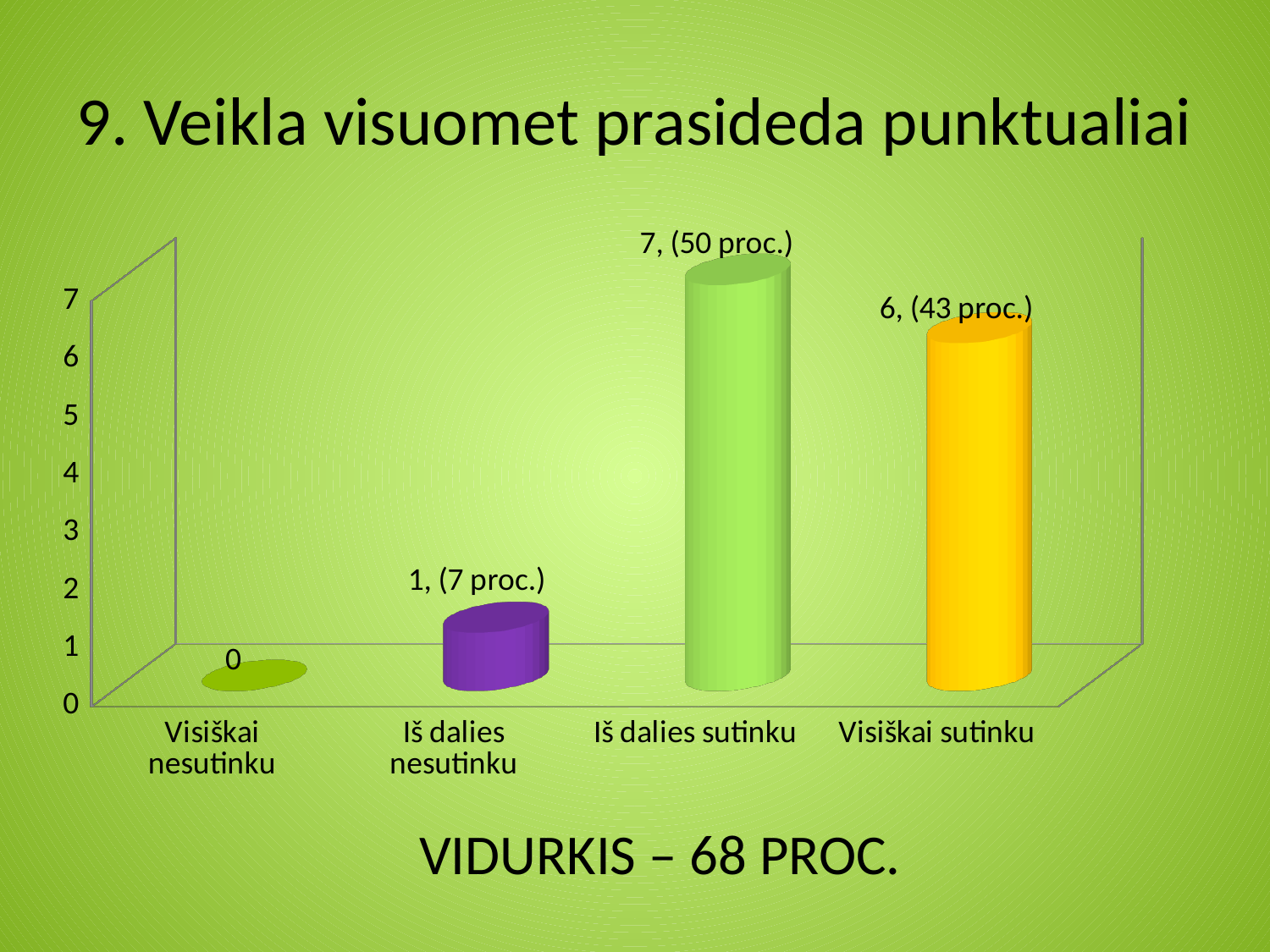
What value is shown for "Visiškai nesutinku"? 0 What is the title of the slide containing the chart? 9. Veikla visuomet prasideda punktualiai What is the difference in count between "Iš dalies sutinku" and "Visiškai sutinku"? 1 Which category has the lowest value? Visiškai nesutinku Which category has the highest value? Iš dalies sutinku Which is larger, the value for "Iš dalies nesutinku" or the value for "Visiškai sutinku"? Visiškai sutinku Is the value for "Visiškai sutinku" greater or less than 4? greater What value is shown for "Visiškai sutinku"? 6, (43 proc.) What value is shown for "Iš dalies sutinku"? 7, (50 proc.) How many categories are shown on the x axis? 4 What value is shown for "Iš dalies nesutinku"? 1, (7 proc.) What kind of chart is shown on the slide? bar chart